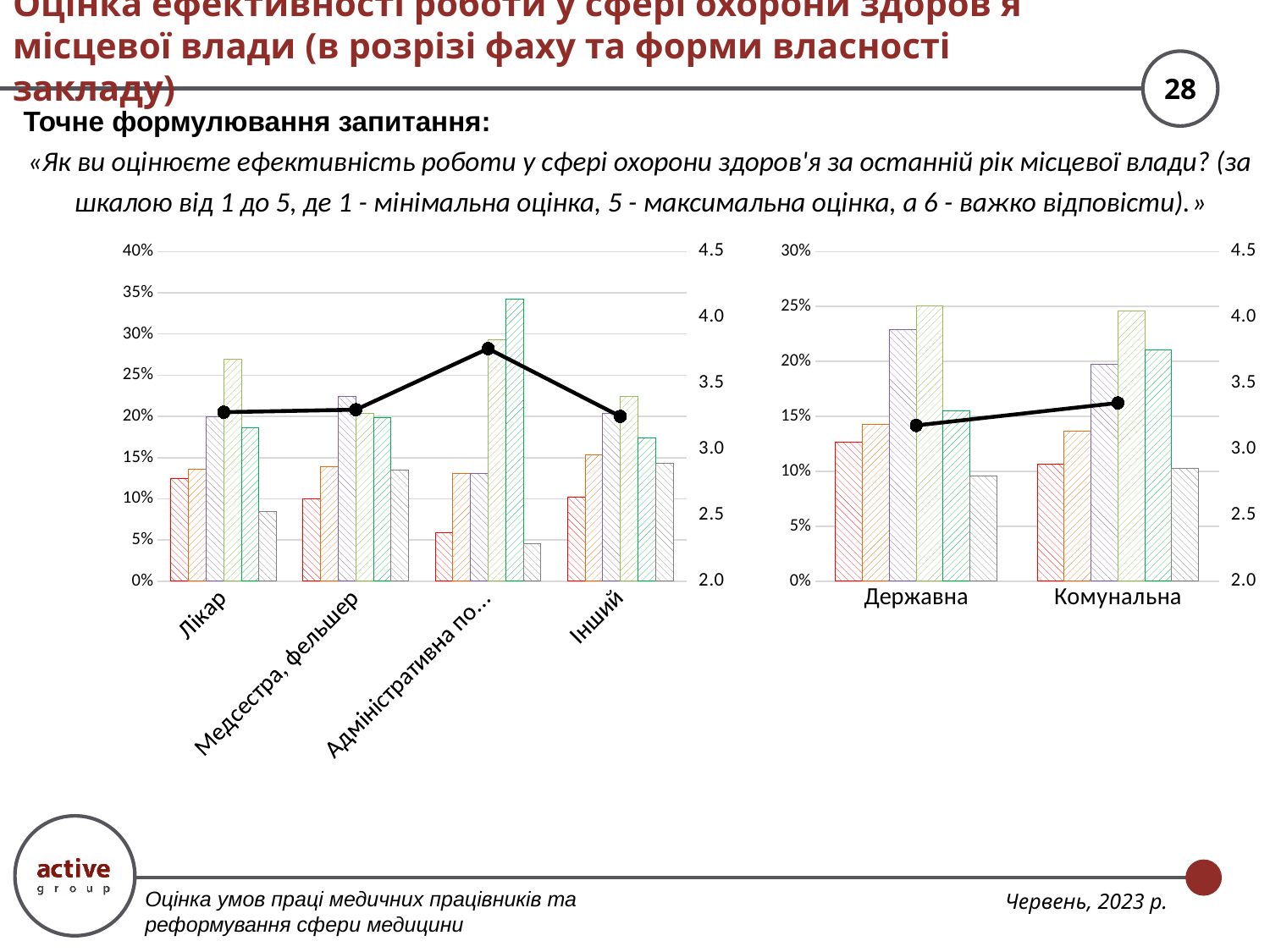
In the left chart, is the tallest bar in the Адміністративна по... group greater or less than 30%? greater In the left chart, which has the higher line value: Лікар or Адміністративна по...? Адміністративна по... What is the maximum value shown on the left percentage axis of the right chart? 30% What kind of chart is the left chart? Bar chart with a line In the right chart, does the line rise or fall from Державна to Комунальна? rise How many categories are shown on the x axis of the right chart? 2 In the left chart, is the line value for Адміністративна по... greater or less than 3.5 on the right axis? greater In the right chart, is the line value for Державна greater or less than 3.5 on the right axis? less In the left chart, for which category does the line reach its highest point? Адміністративна по... How many categories are shown on the x axis of the left chart? 4